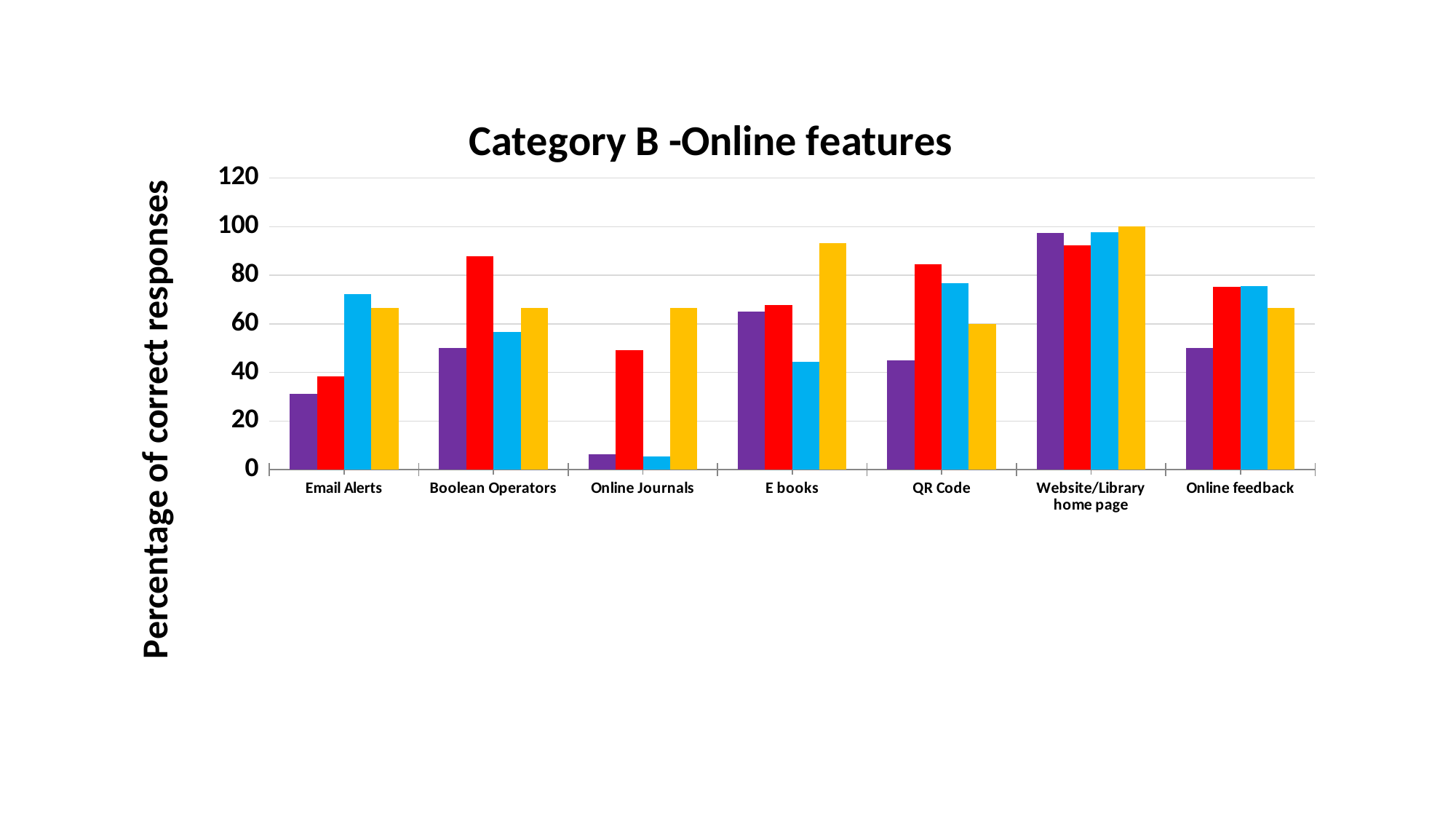
Is the purple bar for Online Journals greater or less than 20? less What is the title of the chart? Category B -Online features How many bars are plotted for each category in the chart? 4 Is the purple bar for Email Alerts greater or less than 40? less What kind of chart is shown on the slide? bar chart What is the label on the vertical axis of the chart? Percentage of correct responses Which is larger, the red bar for Boolean Operators or the red bar for Email Alerts? Boolean Operators Is the red bar for Online Journals greater or less than 40? greater Which category has the highest purple bar? Website/Library home page How many categories are shown along the x axis of the chart? 7